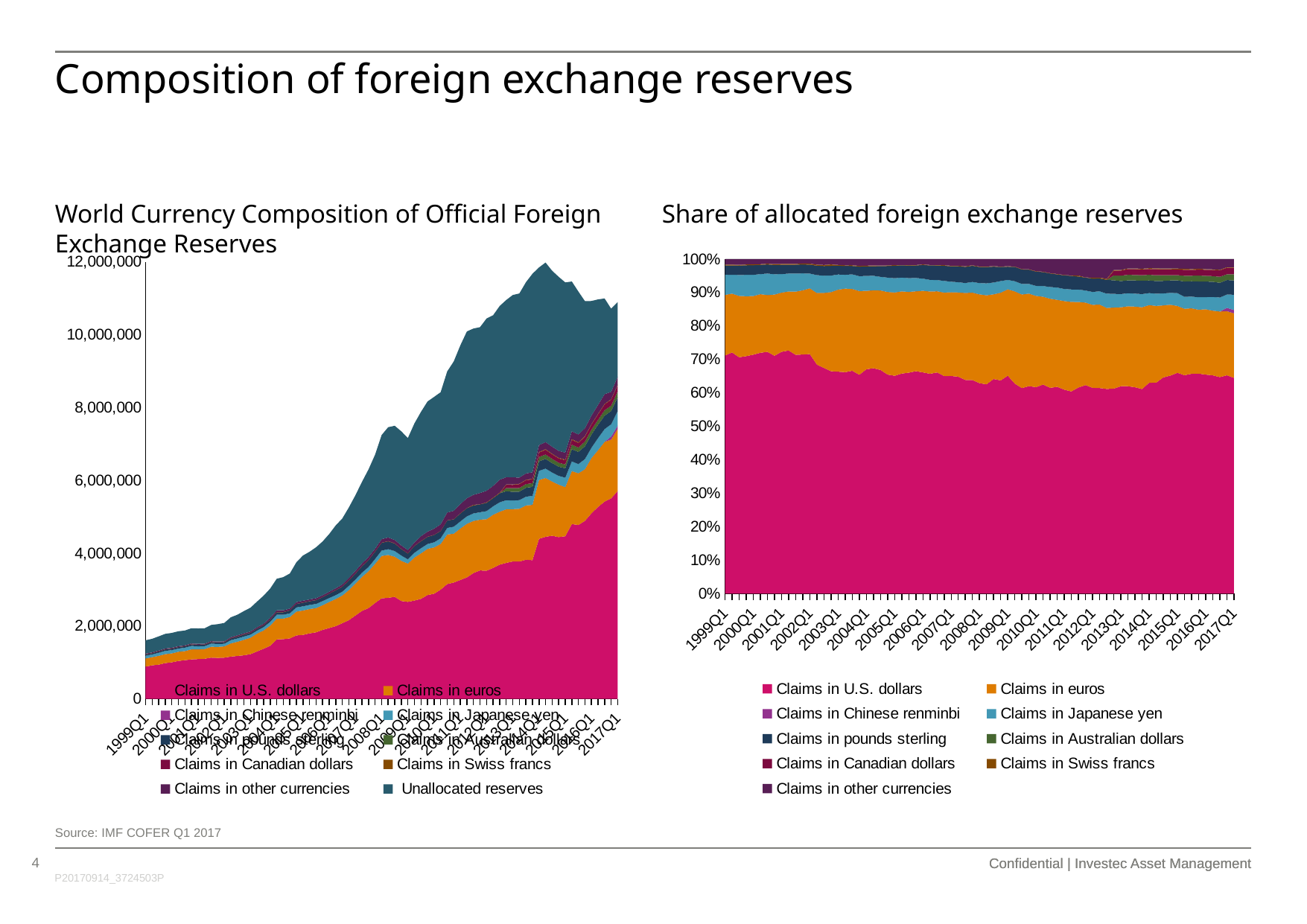
In the right chart, 'Share of allocated foreign exchange reserves', is the share of claims in U.S. dollars at 1999Q1 greater or less than 70%? greater Which series appears in the legend of the left chart but not in the legend of the right chart? Unallocated reserves In the right chart, 'Share of allocated foreign exchange reserves', does the share of claims in U.S. dollars generally rise or fall from 1999Q1 to 2017Q1? Fall What kind of chart is the left chart, 'World Currency Composition of Official Foreign Exchange Reserves'? Stacked area chart How many series does the legend of the left chart, 'World Currency Composition of Official Foreign Exchange Reserves', list? 10 How many series does the legend of the right chart, 'Share of allocated foreign exchange reserves', list? 9 In the left chart, 'World Currency Composition of Official Foreign Exchange Reserves', does the total of all stacked series generally rise or fall from 1999Q1 to 2017Q1? Rise What kind of chart is the right chart, 'Share of allocated foreign exchange reserves'? Stacked area chart In the right chart, 'Share of allocated foreign exchange reserves', is the share of claims in U.S. dollars at 2017Q1 greater or less than 70%? less In the left chart, 'World Currency Composition of Official Foreign Exchange Reserves', is the total of all stacked series at 1999Q1 greater or less than 2,000,000? less What is the first year-quarter label on the x axis of the right chart, 'Share of allocated foreign exchange reserves'? 1999Q1